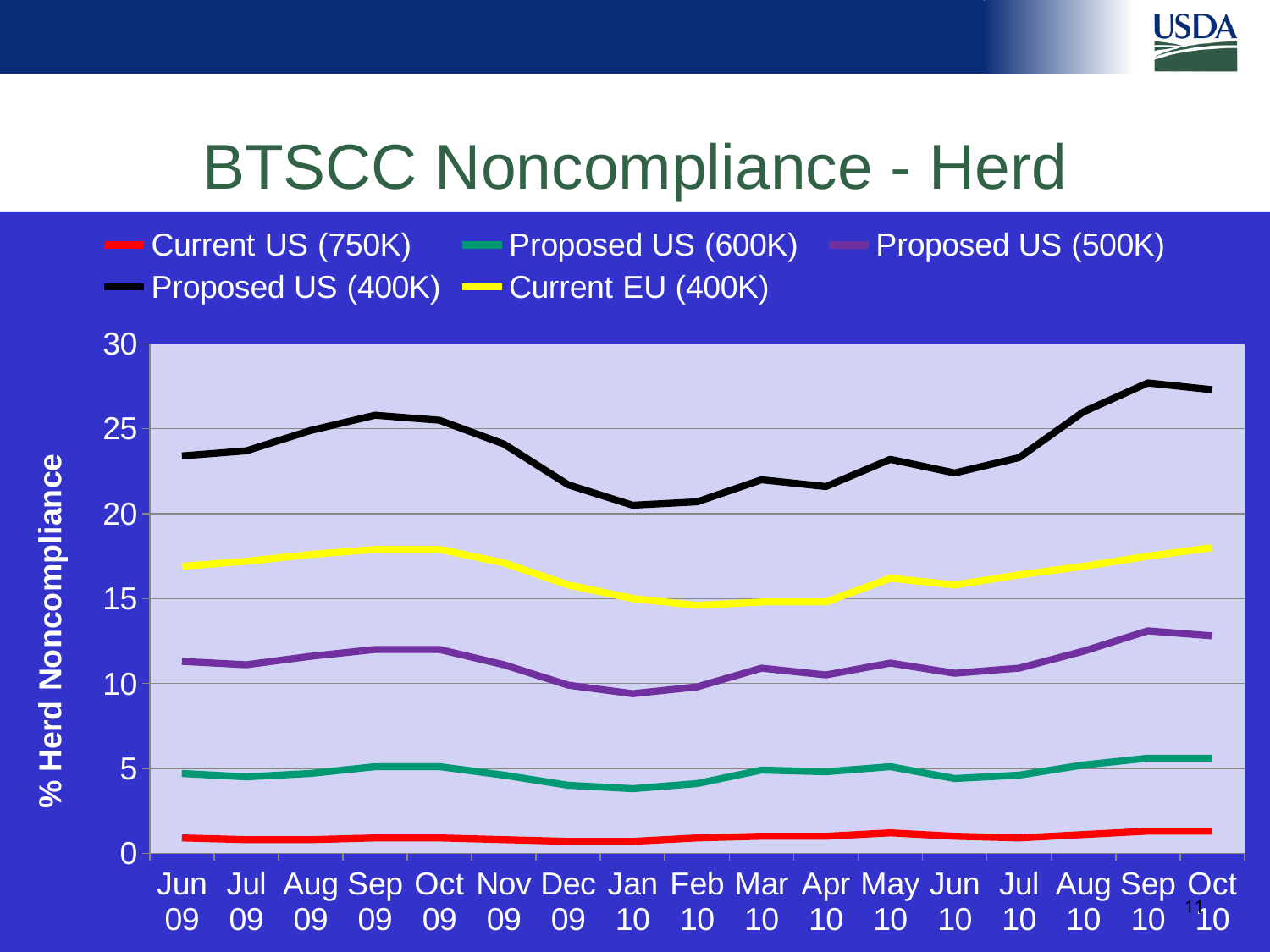
Is the value for Proposed US (500K) in Jun 09 greater or less than 10? greater How many months are plotted along the x axis? 17 How many series does the legend list? 5 Does the Proposed US (400K) line rise or fall from Sep 09 to Jan 10? fall Is the value for Current EU (400K) in Jan 10 greater or less than 20? less Is the value for Proposed US (600K) in Jan 10 greater or less than 5? less Which series has the highest values across the whole period? Proposed US (400K) Which series has the lowest values across the whole period? Current US (750K) What kind of chart is shown on the slide? line chart What is the label on the y axis? % Herd Noncompliance Which is larger in Oct 10: Current EU (400K) or Proposed US (500K)? Current EU (400K)